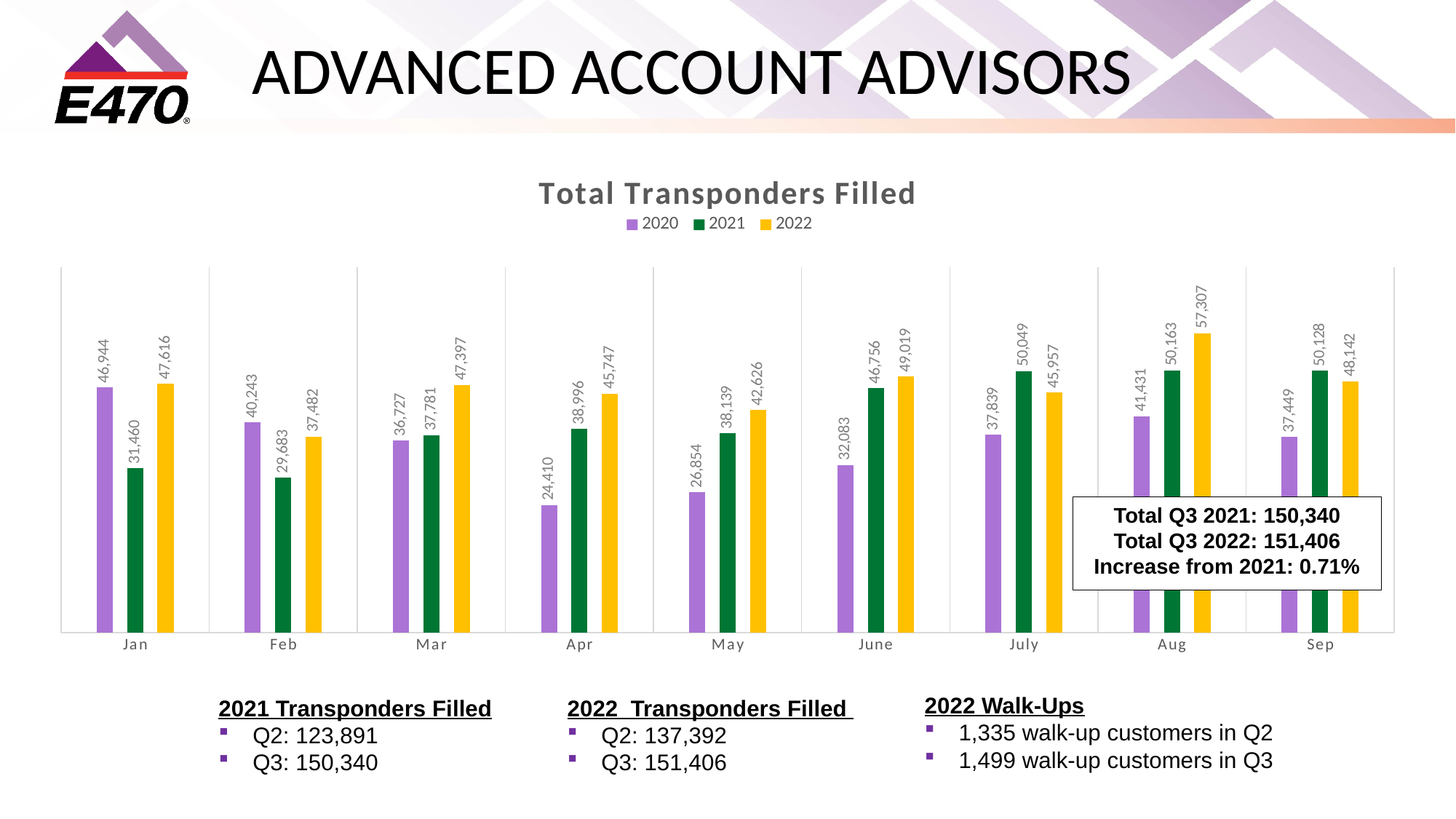
What is the value for 2021 in July? 50,049 How many months are shown on the x axis? 9 What is the value for 2022 in Aug? 57,307 What is the difference between the 2022 and 2021 values in Aug? 7,144 Which is larger in July: the 2021 value or the 2022 value? 2021 What is the title of the chart? Total Transponders Filled Which is larger in Feb: the 2020 value or the 2021 value? 2020 How many series does the legend list? 3 What kind of chart is this? Bar chart Which month has the highest value for the 2022 series? Aug What is the value for 2020 in Apr? 24,410 Which month has the lowest value for the 2020 series? Apr